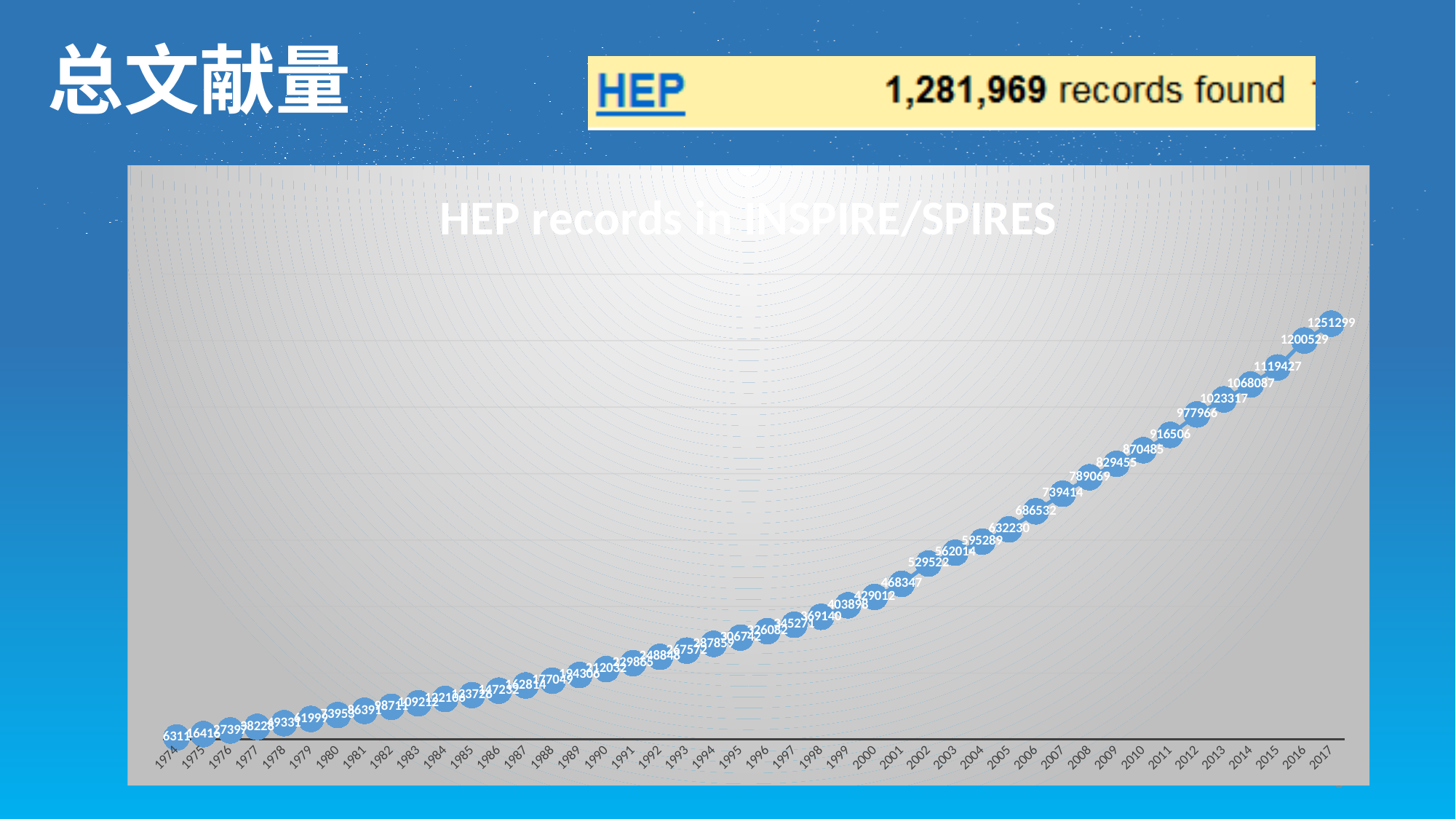
How many years are plotted on the x axis of the chart? 44 Which year has the lowest value in the chart? 1974 Do the values rise or fall from 1974 to 2017? rise What is the value for 2017 in the chart? 1251299 What is the title of the chart? HEP records in INSPIRE/SPIRES What kind of chart is shown on the slide? line chart What is the value for 2000 in the chart? 429012 What is the value for 2005 in the chart? 632230 Which year has the highest value in the chart? 2017 What is the difference between the values for 2017 and 2016? 50770 Which is larger, the value for 2013 or the value for 2008? 2013 What is the value for 2010 in the chart? 870485